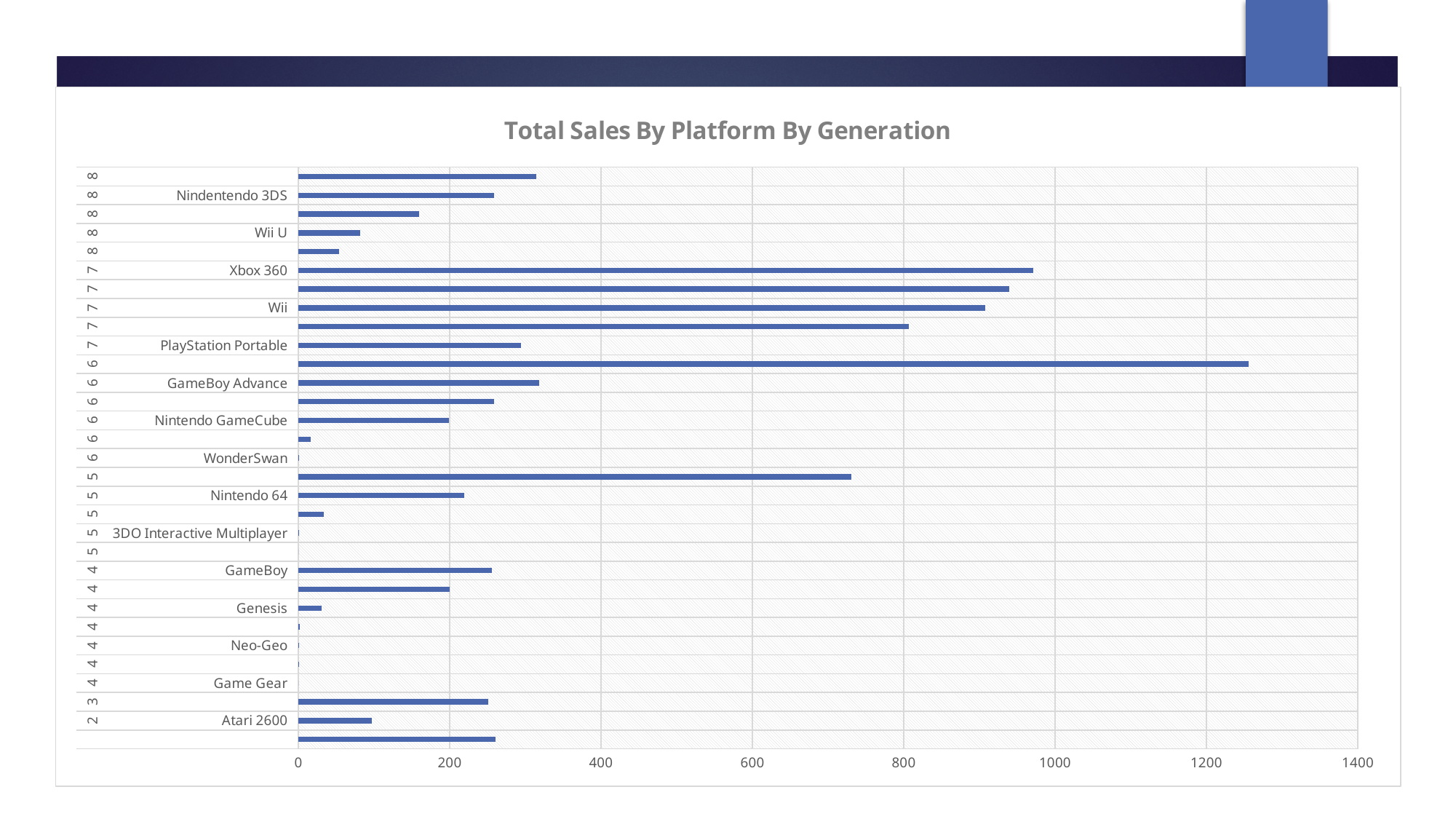
Which has the larger value, Nindentendo 3DS or Wii U? Nindentendo 3DS What kind of chart is shown on the slide? bar chart Is the value for Genesis greater or less than 200? less Is the value for PlayStation Portable greater or less than 400? less Is the value for Wii greater or less than 800? greater What is the title of the chart? Total Sales By Platform By Generation Which has the larger value, PlayStation Portable or Atari 2600? PlayStation Portable Which has the larger value, Xbox 360 or Wii? Xbox 360